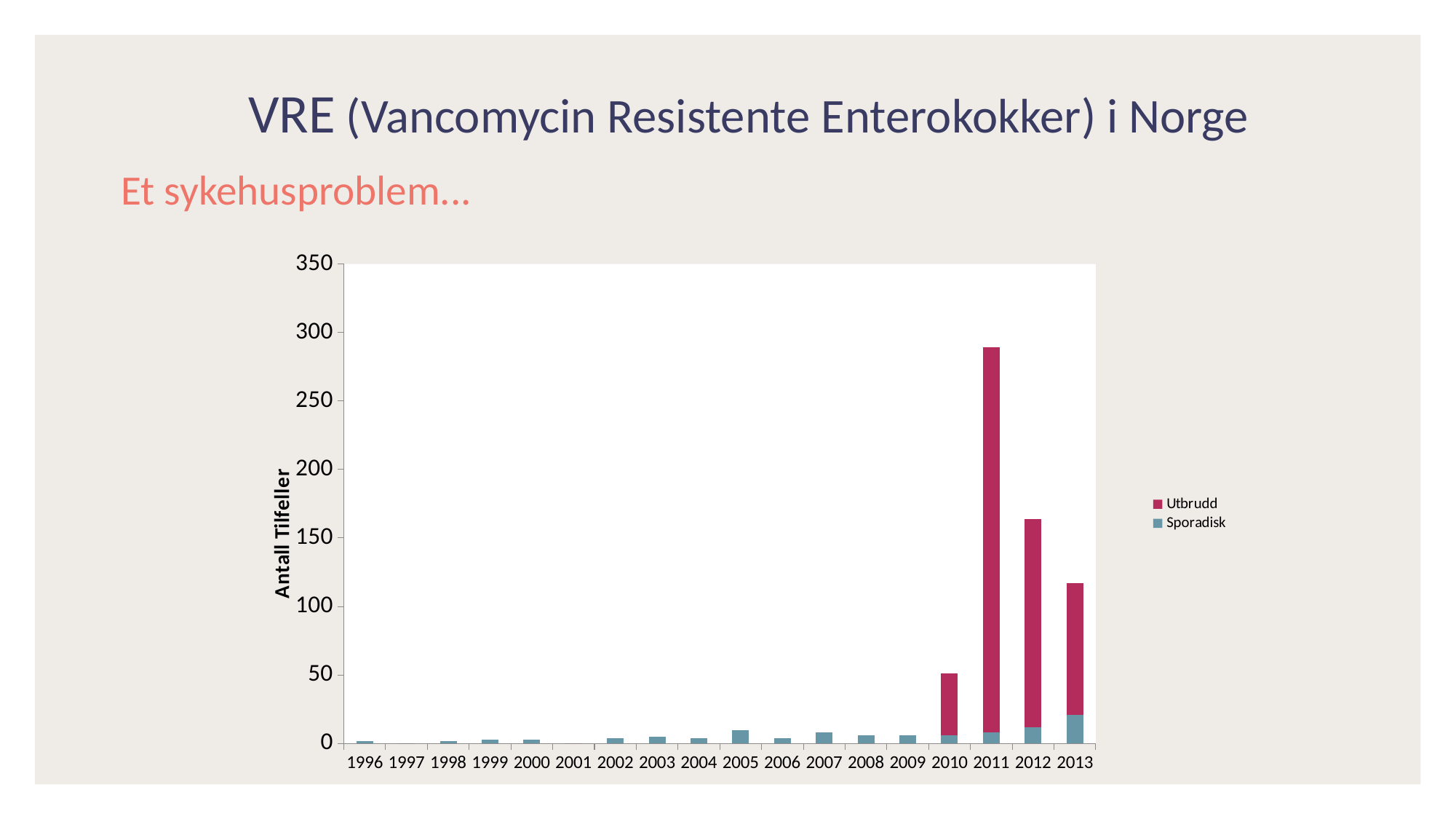
Is the total for 2013 greater or less than 100? greater Is the total for 2011 greater or less than 250? greater What kind of chart is shown on the slide? stacked bar chart Is the total for 2010 greater or less than 100? less Which year has the tallest bar? 2011 How many years are shown on the x axis? 18 Which year has the larger total, 2011 or 2012? 2011 How many series does the legend list? 2 What are the two series named in the legend? Utbrudd and Sporadisk What is the label on the y axis? Antall Tilfeller Do the totals rise or fall from 2011 to 2013? fall